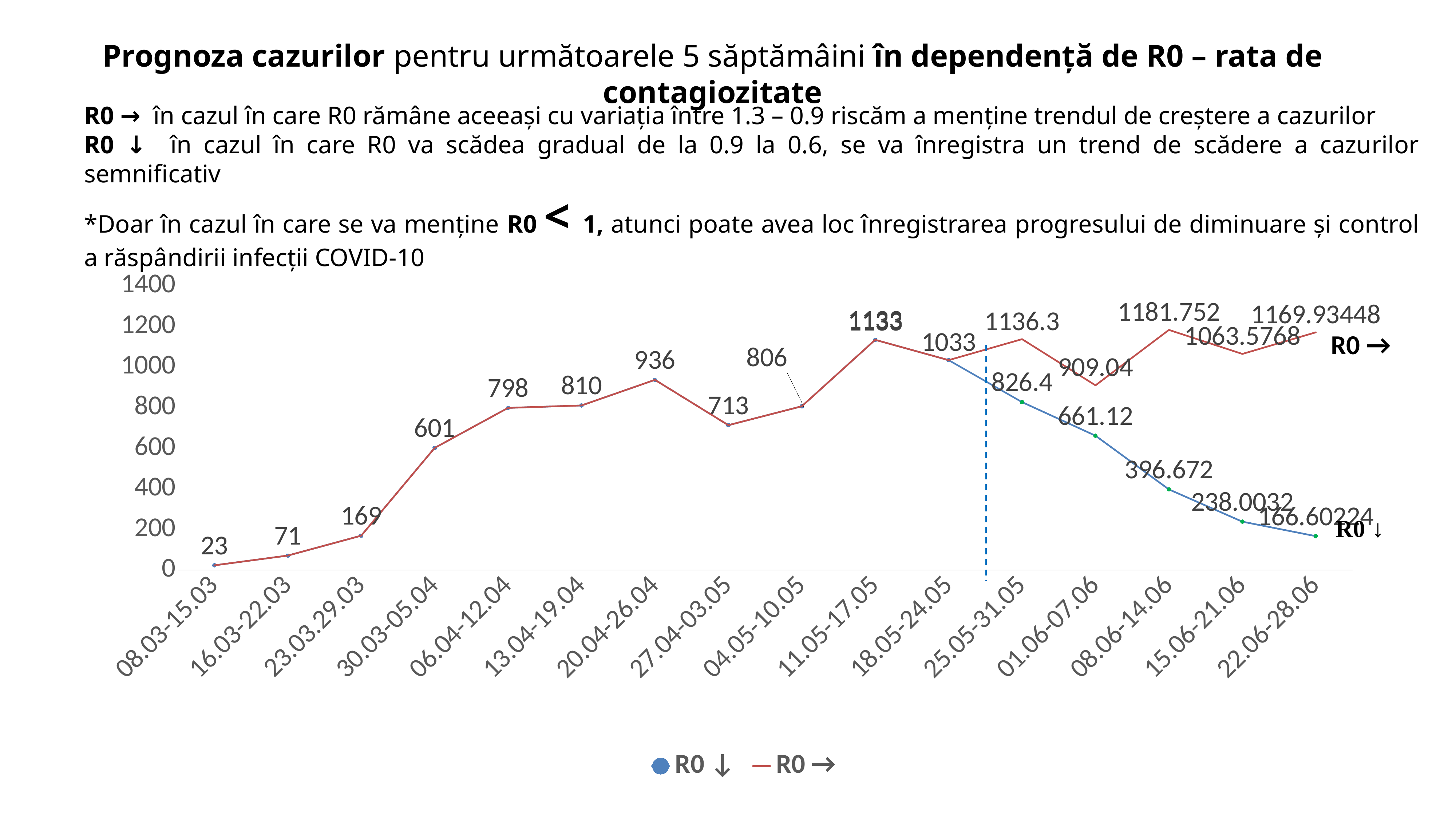
Which week has the highest value on the R0 → line? 08.06-14.06 How many series does the legend list? 2 What is the R0 → value for the week 22.06-28.06? 1169.93448 How many week categories are shown on the x axis? 16 What is the difference between the values for 11.05-17.05 and 18.05-24.05? 100 What is the R0 ↓ value for the week 22.06-28.06? 166.60224 What is the value for the week 30.03-05.04? 601 What kind of chart is shown on the slide? line chart What is the difference between the R0 → value and the R0 ↓ value for the week 08.06-14.06? 785.08 Which week has the lowest value on the chart? 08.03-15.03 Does the R0 ↓ line rise or fall from 25.05-31.05 to 22.06-28.06? fall For the week 25.05-31.05, which series has the larger value, R0 → or R0 ↓? R0 →